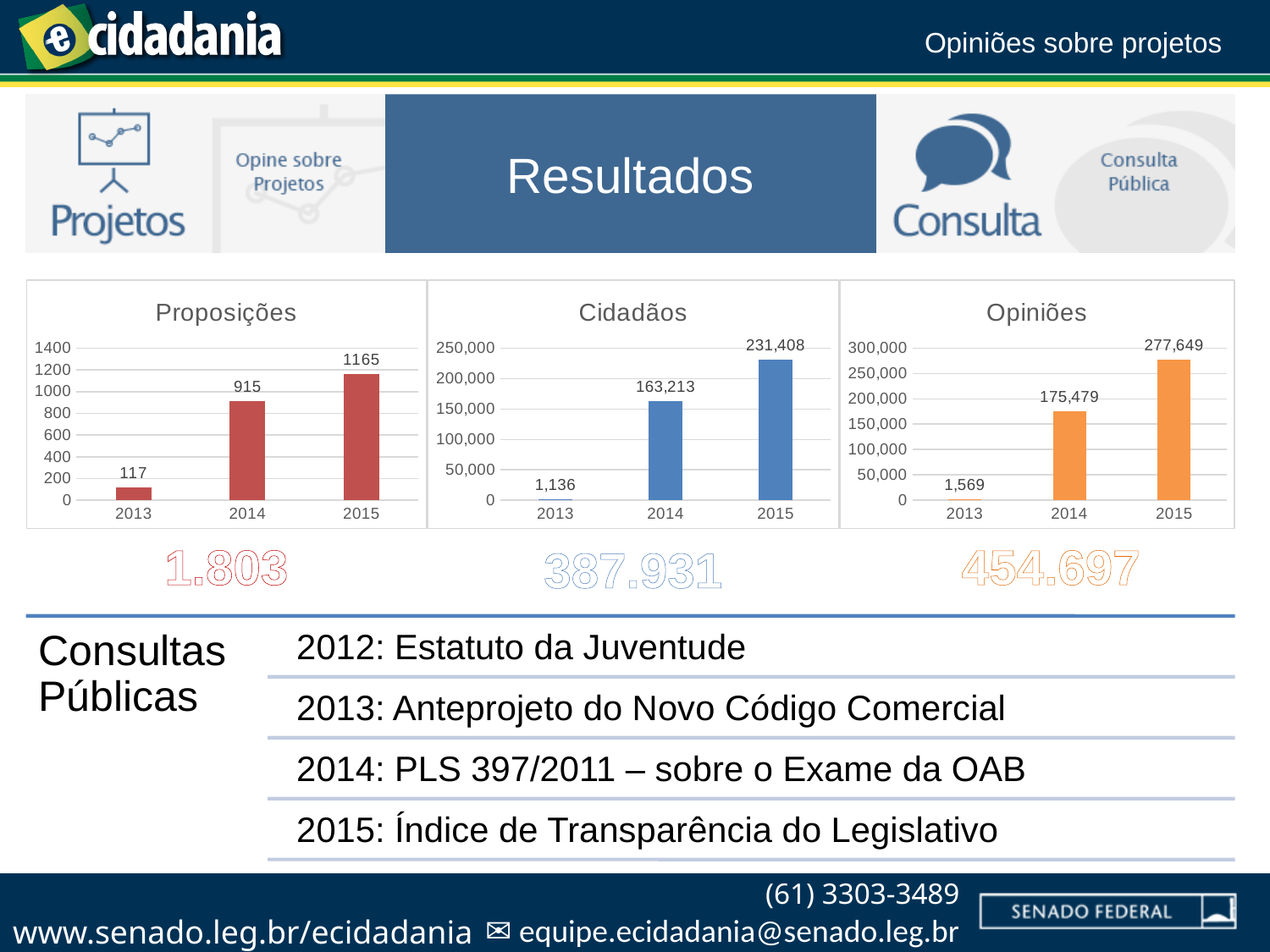
In the Opiniões chart, is the value for 2014 greater or less than 200,000? less In the Cidadãos chart, which year has the lowest value? 2013 In the Proposições chart, which year has the highest value? 2015 In the Proposições chart, what is the value for 2014? 915 How many years are shown on the x axis of the Proposições chart? 3 What kind of chart is the Cidadãos chart? bar chart In the Cidadãos chart, which is larger, the value for 2014 or the value for 2015? 2015 In the Opiniões chart, what is the difference between the 2015 and 2014 values? 102,170 In the Opiniões chart, do the values rise or fall from 2013 to 2015? rise In the Opiniões chart, what is the value for 2013? 1,569 In the Proposições chart, what is the difference between the 2015 and 2014 values? 250 In the Cidadãos chart, what is the value for 2015? 231,408